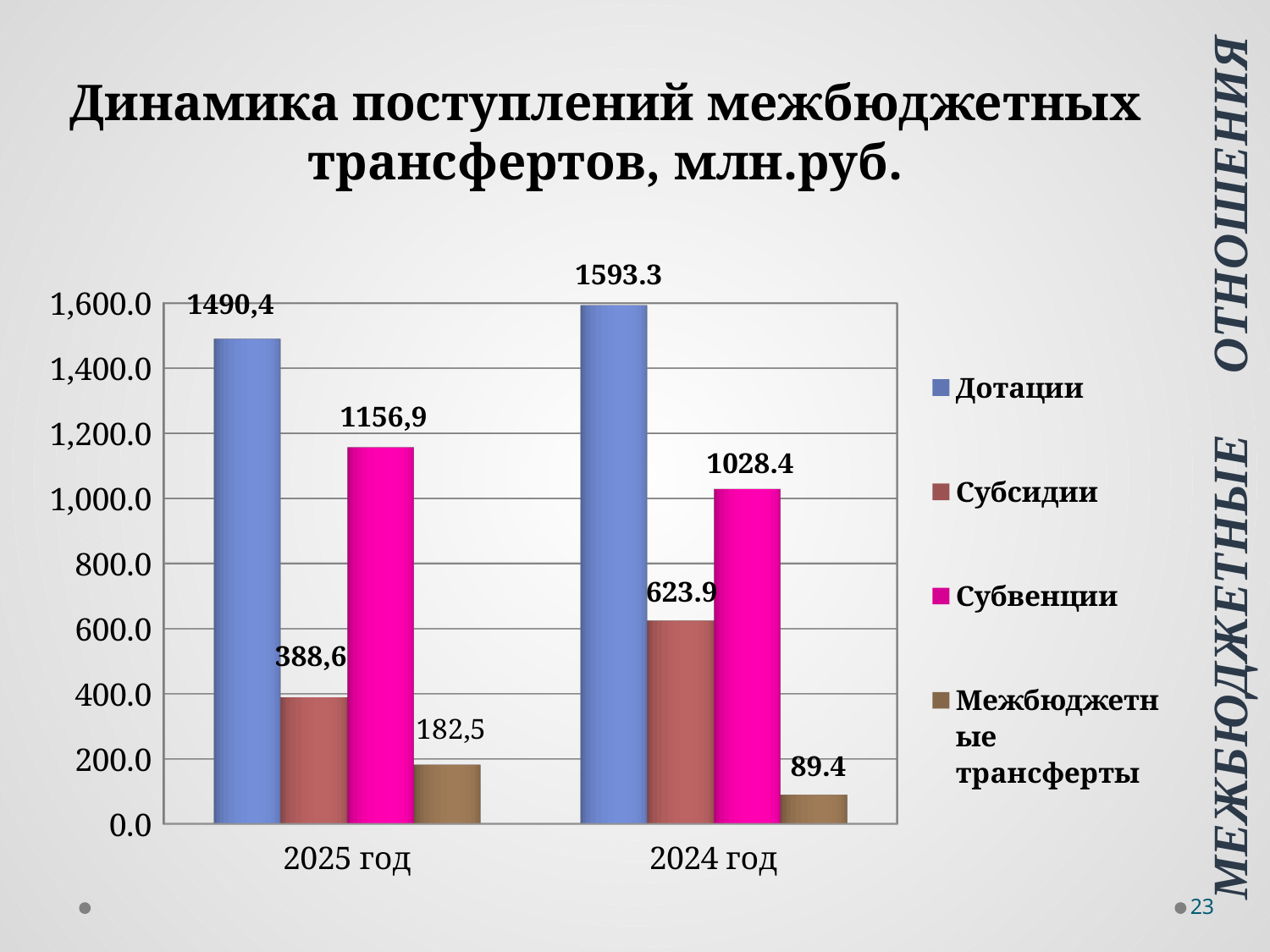
How many categories are shown on the x axis? 2 What is the difference between Дотации and Субвенции in 2024 год? 564.9 What is the value for Субсидии in 2024 год? 623.9 Which series has the highest value in 2024 год? Дотации What kind of chart is shown on the slide? bar chart What is the value for Межбюджетные трансферты in 2025 год? 182,5 How many series does the legend list? 4 What is the value for Дотации in 2025 год? 1490,4 Which is larger: Субсидии in 2025 год or Субсидии in 2024 год? Субсидии in 2024 год Which series has the lowest value in 2025 год? Межбюджетные трансферты What colour are the bars for Субвенции? magenta (pink) What is the value for Субвенции in 2024 год? 1028.4